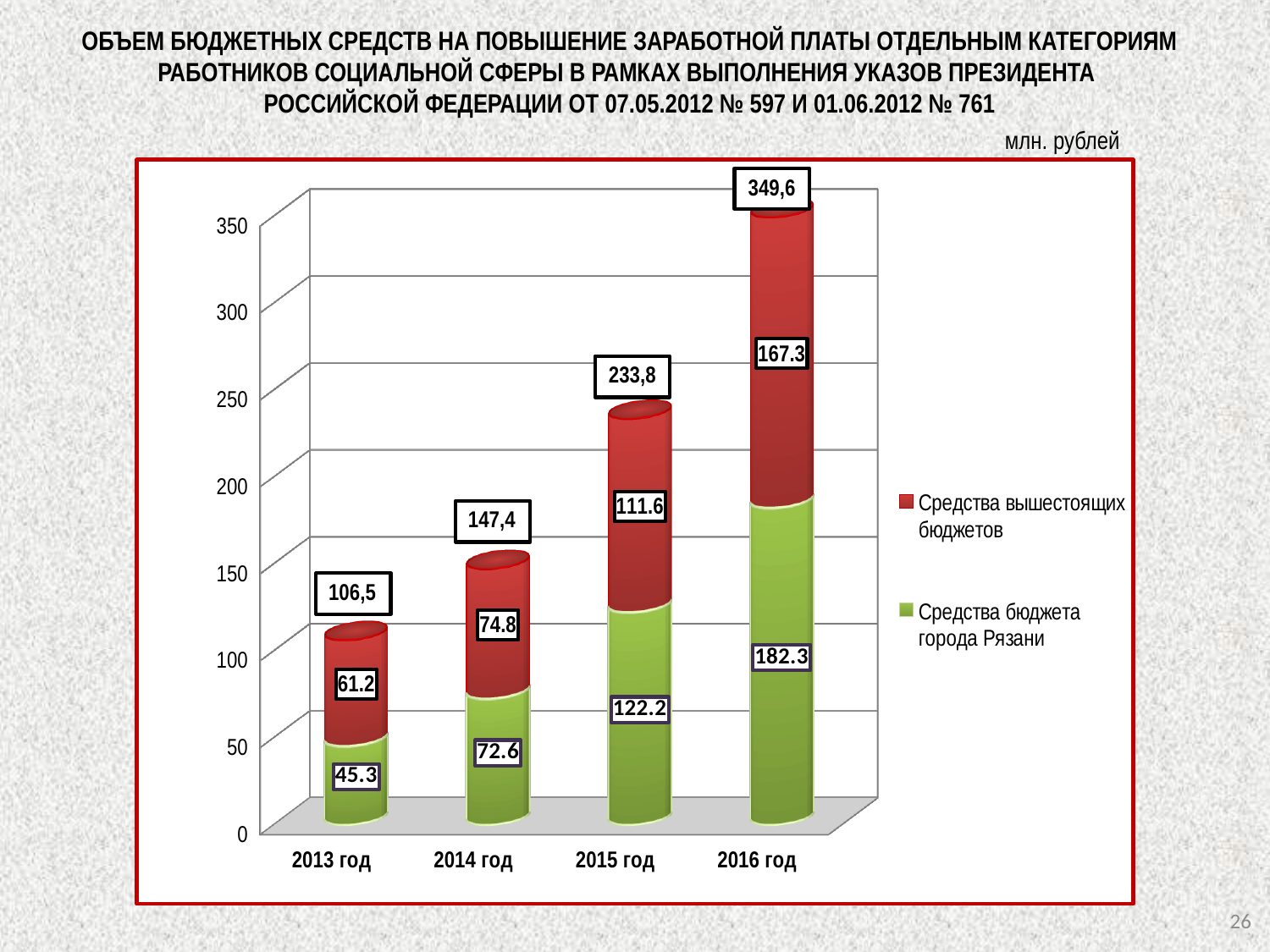
What kind of chart is shown on the slide? Stacked bar chart How many years are shown on the x axis? 4 What is the total shown above the stacked bar for 2013 год? 106,5 What is the value for "Средства бюджета города Рязани" in 2015 год? 122.2 Which is larger in 2016 год: "Средства вышестоящих бюджетов" or "Средства бюджета города Рязани"? Средства бюджета города Рязани Which year has the highest total value? 2016 год Do the total values rise or fall from 2013 год to 2016 год? Rise What is the value for "Средства вышестоящих бюджетов" in 2014 год? 74.8 Which year has the lowest value for "Средства бюджета города Рязани"? 2013 год How many series does the legend list? 2 What is the difference between the "Средства бюджета города Рязани" values for 2016 год and 2015 год? 60.1 What is the total shown above the stacked bar for 2016 год? 349,6